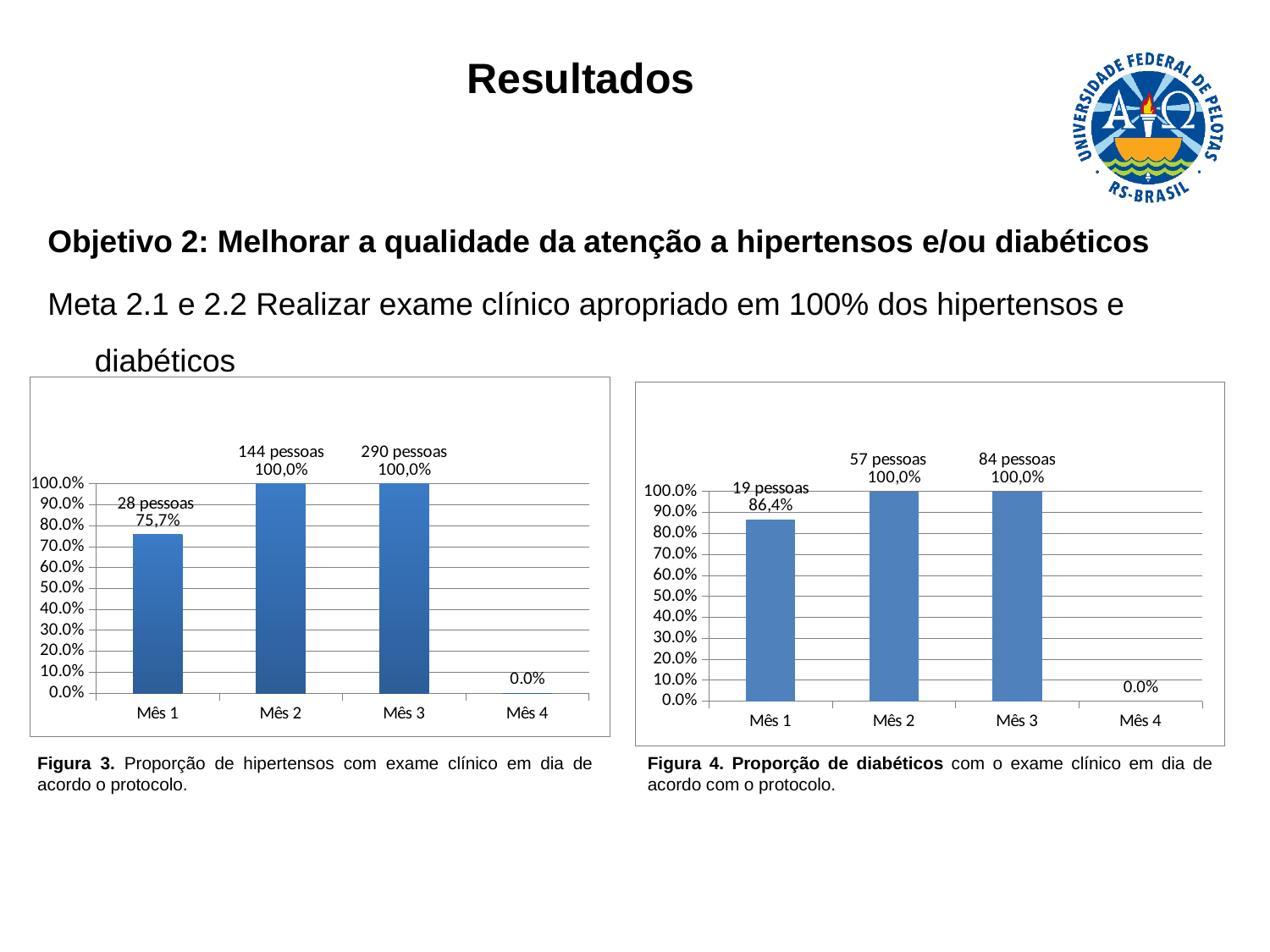
In the left chart (Figura 3), what is the difference in percentage points between Mês 2 and Mês 1? 24,3 In the right chart (Figura 4), how many people does the Mês 2 label report? 57 pessoas In the left chart (Figura 3), is the value for Mês 1 greater or less than 70.0%? greater In the right chart (Figura 4), which month has the lowest value? Mês 4 In the right chart (Figura 4), which is larger, the value for Mês 1 or the value for Mês 3? Mês 3 In the left chart (Figura 3), how many people does the Mês 3 label report? 290 pessoas In the right chart (Figura 4), what is the percentage value for Mês 1? 86,4% In the left chart (Figura 3), what is the percentage value for Mês 1? 75,7% How many months (categories) are shown on the x axis of the right chart (Figura 4)? 4 In the right chart (Figura 4), what is the difference in the number of people between Mês 3 and Mês 1? 65 pessoas What type of chart is Figura 3 on the left? Bar chart In the left chart (Figura 3), which month has the lowest value? Mês 4